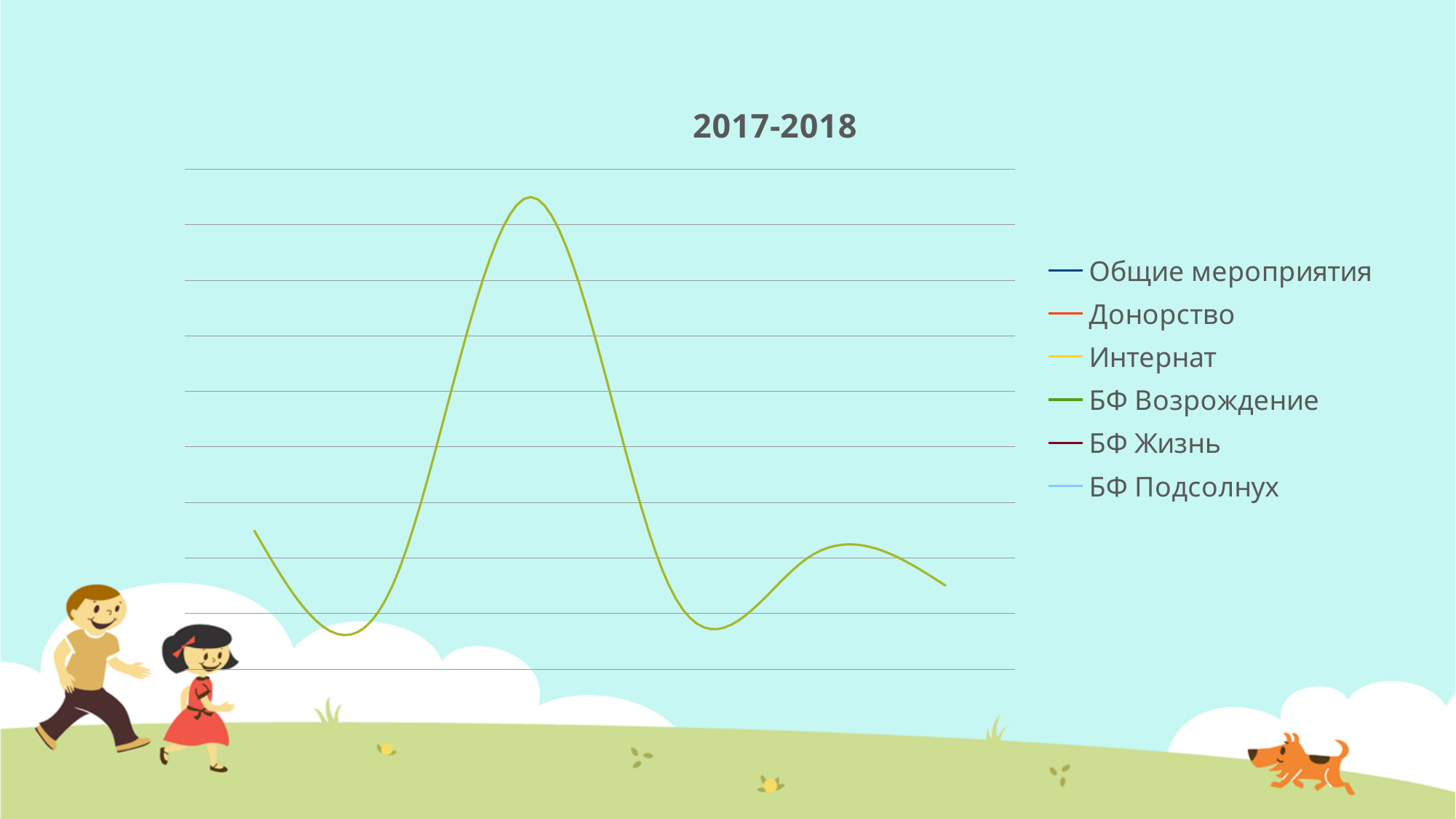
What is the title of the chart? 2017-2018 How many series does the chart's legend list? 6 What kind of chart is shown on the slide? line chart Is the value at the right end of the plotted line higher or lower than the value at its left end? lower